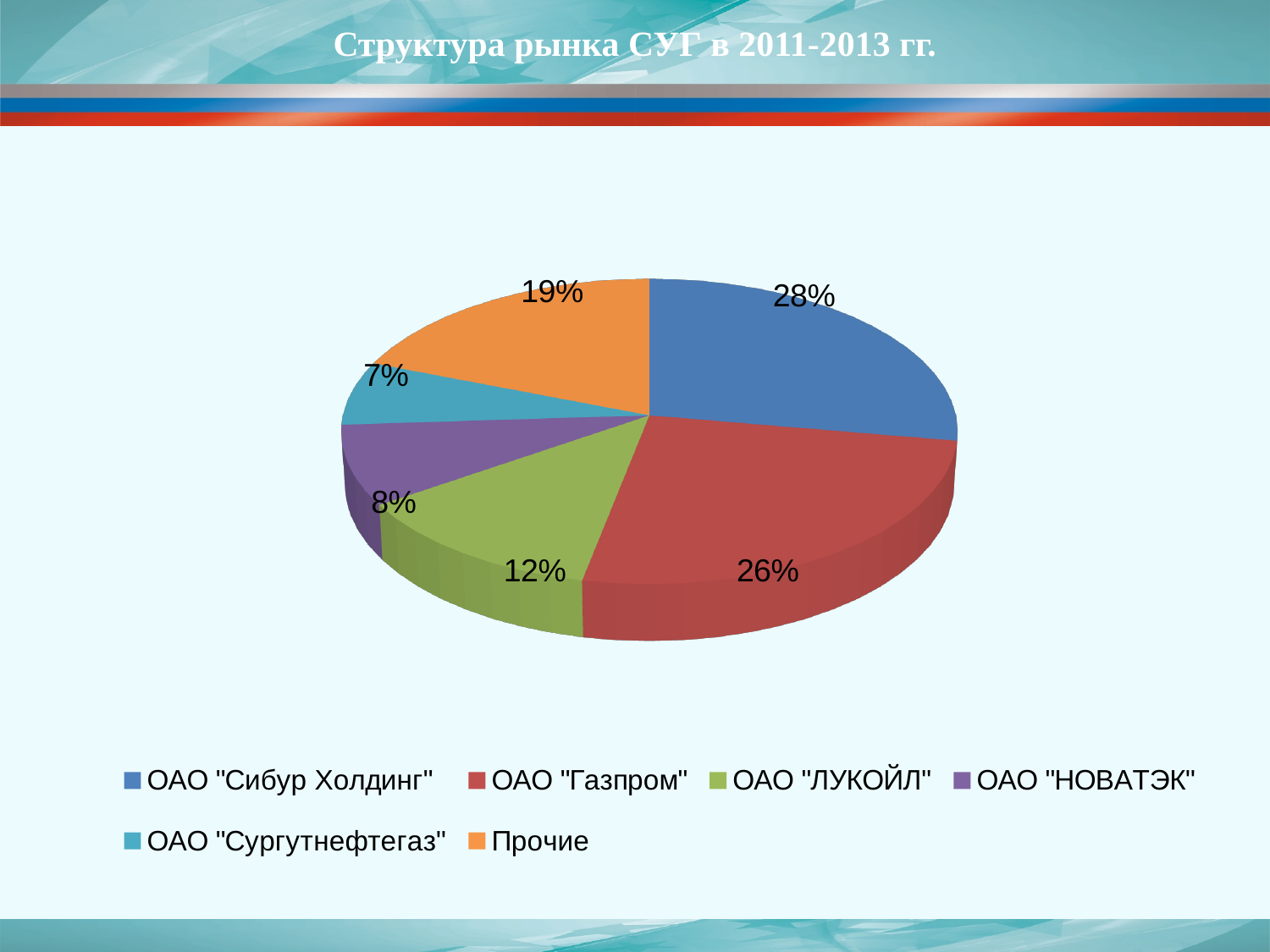
Which category has the largest slice of the pie? ОАО "Сибур Холдинг" Which category has the smallest slice of the pie? ОАО "Сургутнефтегаз" What type of chart is shown on the slide? Pie chart What is the difference in percentage points between the shares of ОАО "Сибур Холдинг" and ОАО "Газпром"? 2 percentage points Which is larger, the share of ОАО "ЛУКОЙЛ" or the share of Прочие? Прочие What share of the pie is labelled Прочие? 19% What share of the pie does ОАО "Газпром" hold? 26% What share of the pie does ОАО "ЛУКОЙЛ" hold? 12% How many slices does the pie chart have? 6